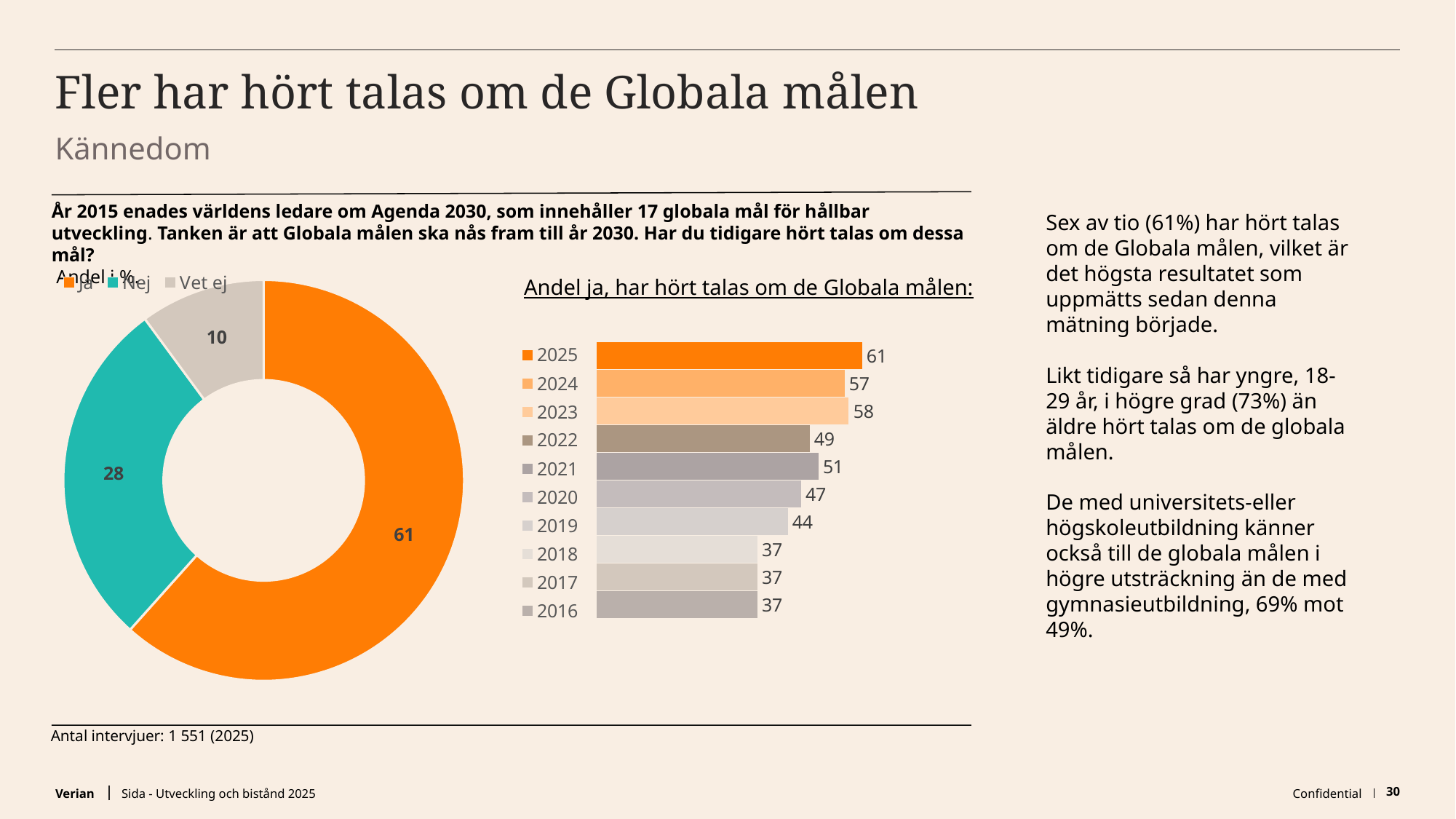
In the donut chart on the left, how many categories does the legend list? 3 In the donut chart on the left, what is the difference between the values for "Ja" and "Nej"? 33 What kind of chart is the chart on the right of the slide? Bar chart In the bar chart "Andel ja, har hört talas om de Globala målen", how many years are shown? 10 In the bar chart "Andel ja, har hört talas om de Globala målen", what is the difference between the values for 2025 and 2016? 24 In the bar chart "Andel ja, har hört talas om de Globala målen", which year has the highest value? 2025 In the donut chart on the left, which category has the smallest share? Vet ej In the donut chart on the left, what is the value for "Ja"? 61 In the donut chart on the left, what is the value for "Vet ej"? 10 In the bar chart "Andel ja, har hört talas om de Globala målen", which is larger, the value for 2022 or the value for 2021? 2021 In the bar chart "Andel ja, har hört talas om de Globala målen", what is the value for 2020? 47 In the bar chart "Andel ja, har hört talas om de Globala målen", what is the value for 2023? 58